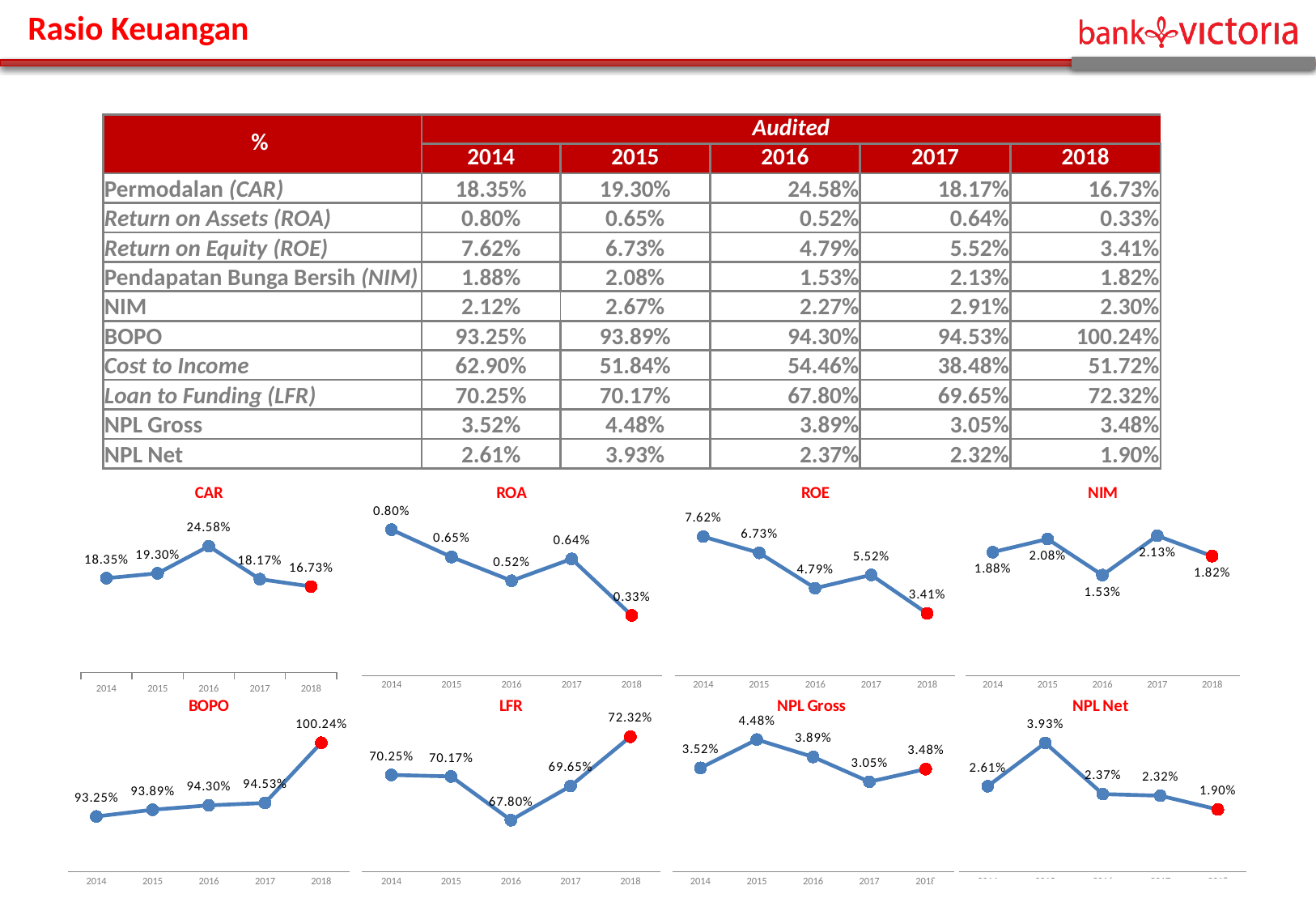
In the BOPO chart, do the values generally rise or fall from 2014 to 2018? rise How many data points are plotted in the ROE chart? 5 In the NPL Net chart, what is the difference between the 2015 value and the 2018 value? 2.03% In the ROA chart, what is the value for 2018? 0.33% In the CAR chart, what is the value for 2016? 24.58% In the NIM chart, which year has the lowest value? 2016 In the CAR chart, what is the difference between the 2016 value and the 2018 value? 7.85% In the ROE chart, which year has the highest value? 2014 In the LFR chart, what is the value for 2016? 67.80% In the NPL Gross chart, which is larger, the value for 2015 or the value for 2016? 2015 What kind of chart is the BOPO chart? line chart How many charts are shown on the slide? 8